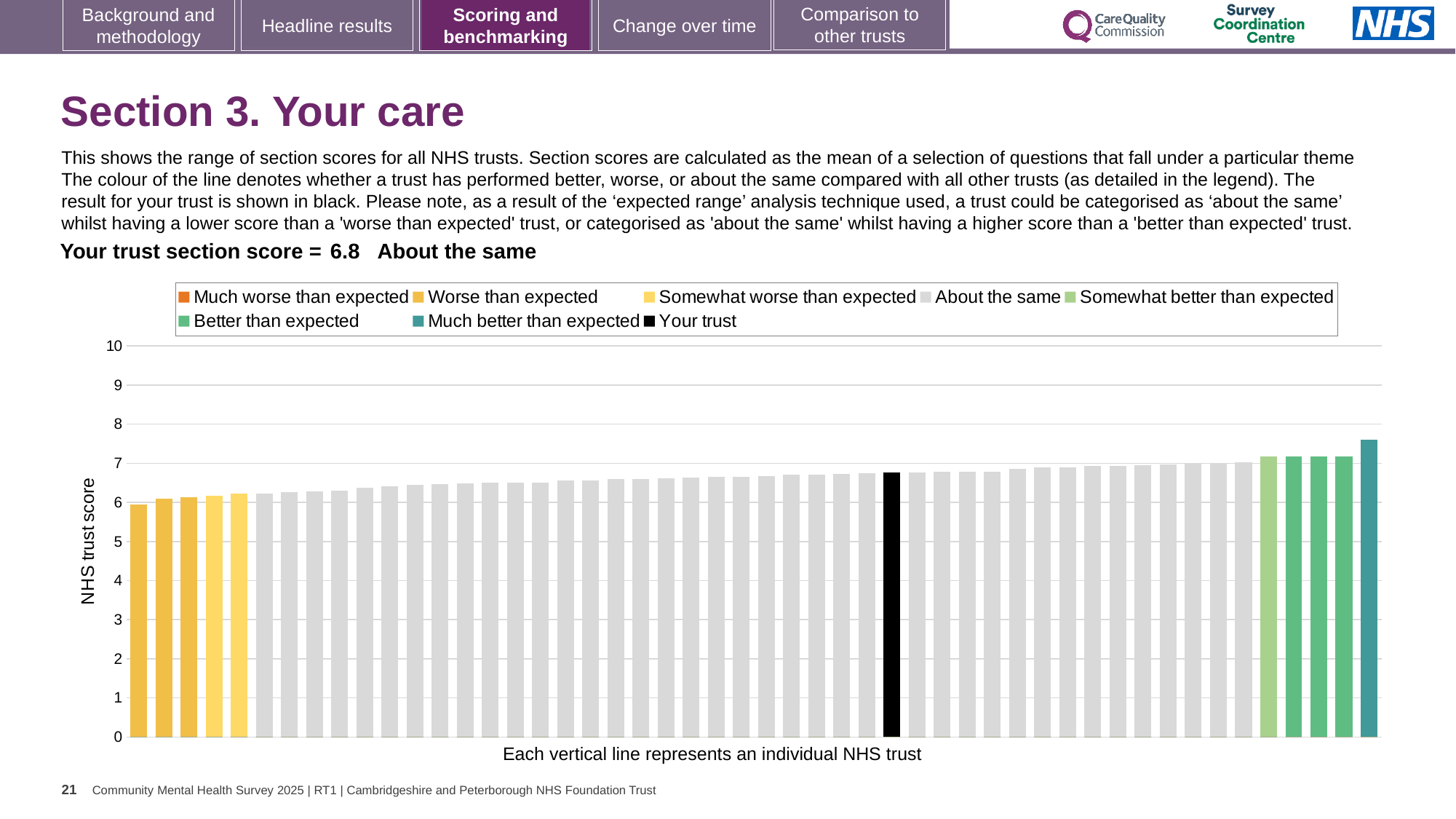
Which category does your trust fall into according to the slide? About the same Is the value of the black 'Your trust' bar greater or less than 6? greater What kind of chart is shown on the slide? bar chart Which bar is the highest: the teal bar at the far right or the black 'Your trust' bar? the teal bar at the far right What is the section score for your trust (the black bar)? 6.8 What colour is used for the 'Your trust' bar in the chart? black How many entries does the chart legend list? 8 Is the value of the tallest bar (the teal 'Much better than expected' bar) greater or less than 7? greater How many bars are coloured teal ('Much better than expected')? 1 Is the value of the leftmost bar greater or less than 7? less What is the label on the y axis of the chart? NHS trust score Do the bar values rise or fall from left to right along the x axis? rise